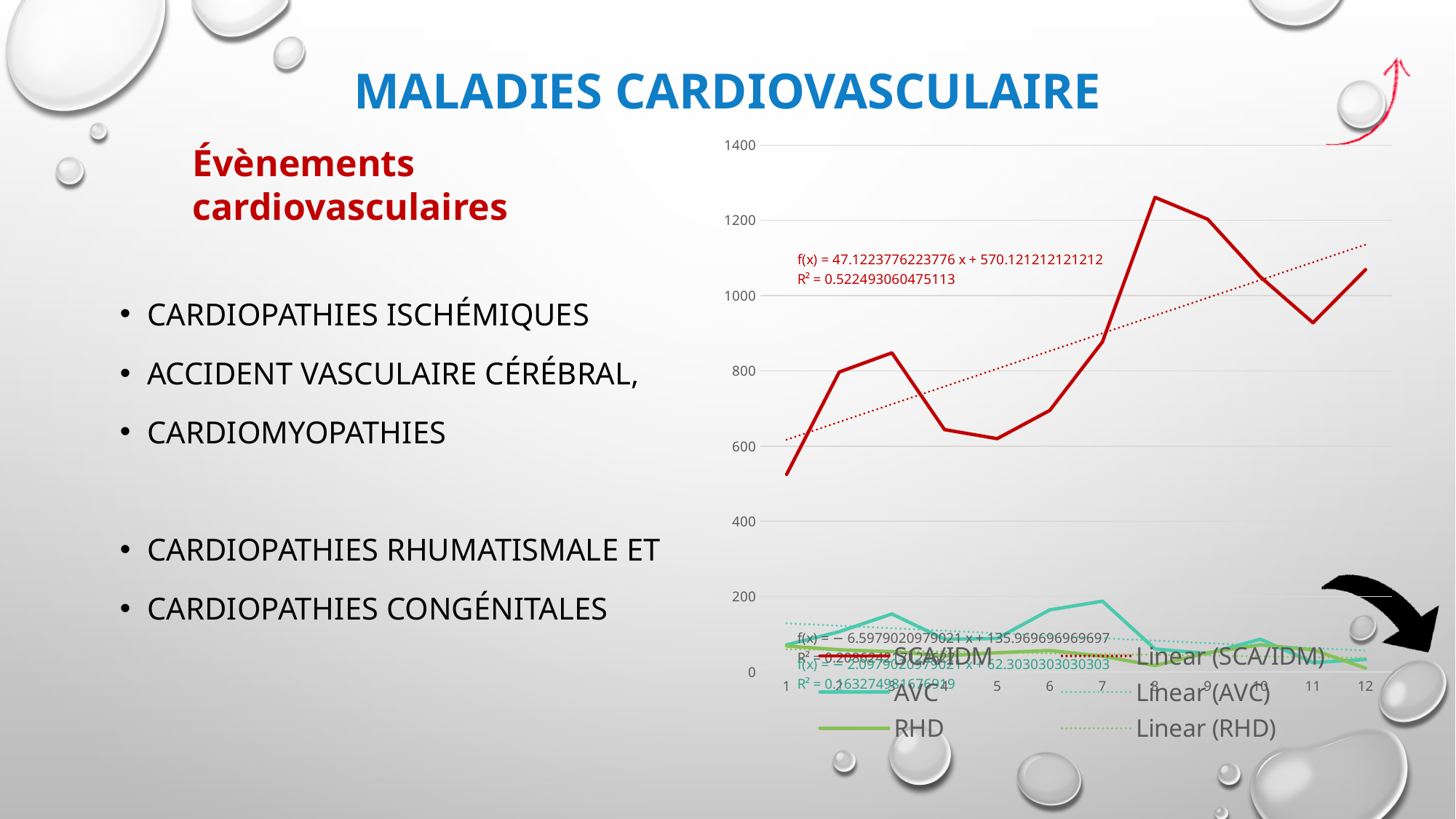
At point 5, which series has the larger value, SCA/IDM or AVC? SCA/IDM Is the value of AVC at point 8 greater or less than 200? less Is the value of SCA/IDM at point 11 greater or less than 1000? less Is the value of SCA/IDM at point 8 greater or less than 1200? greater At which x-axis point does the SCA/IDM series reach its highest value? 8 At which x-axis point does the SCA/IDM series have its lowest value? 1 How many entries does the chart legend list? 6 How many points are plotted along the x axis of the chart? 12 What kind of chart is shown on the slide? line chart What is the R² value printed for the SCA/IDM trendline? 0.522493060475113 Does the linear trendline for SCA/IDM rise or fall from left to right? rise